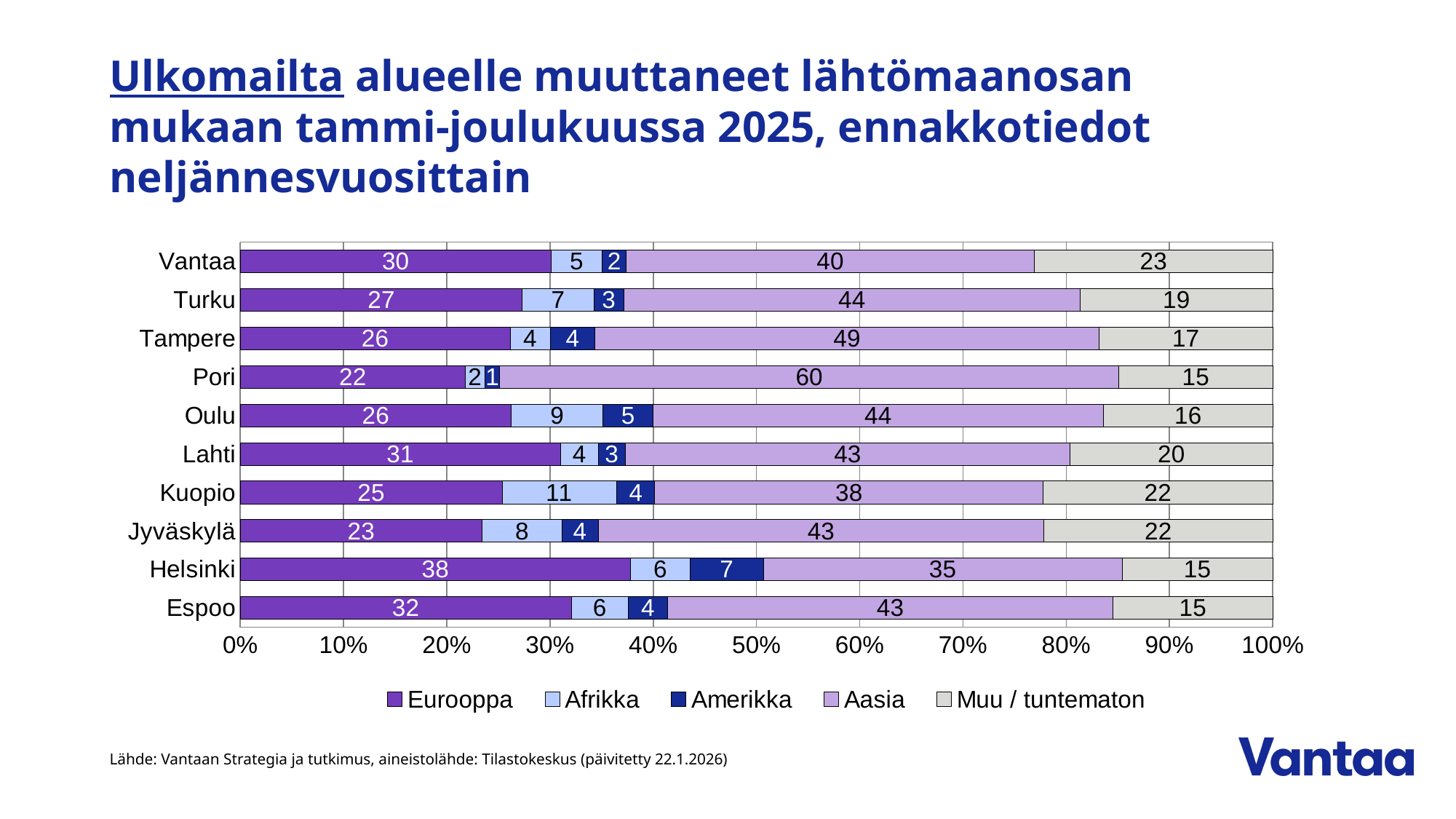
What is the difference between the Aasia and Eurooppa values for Vantaa? 10 Which city has the highest Afrikka value? Kuopio What is the Eurooppa value for Vantaa? 30 Which is larger, the Eurooppa value for Helsinki or for Espoo? Helsinki Which city has the lowest Aasia value? Helsinki Which city has the highest Eurooppa value? Helsinki How many series does the legend list? 5 What is the Muu / tuntematon value for Kuopio? 22 What kind of chart is shown on the slide? Stacked bar chart Which series is shown in the lightest grey colour in the legend? Muu / tuntematon What is the Aasia value for Pori? 60 How many cities are shown on the chart? 10